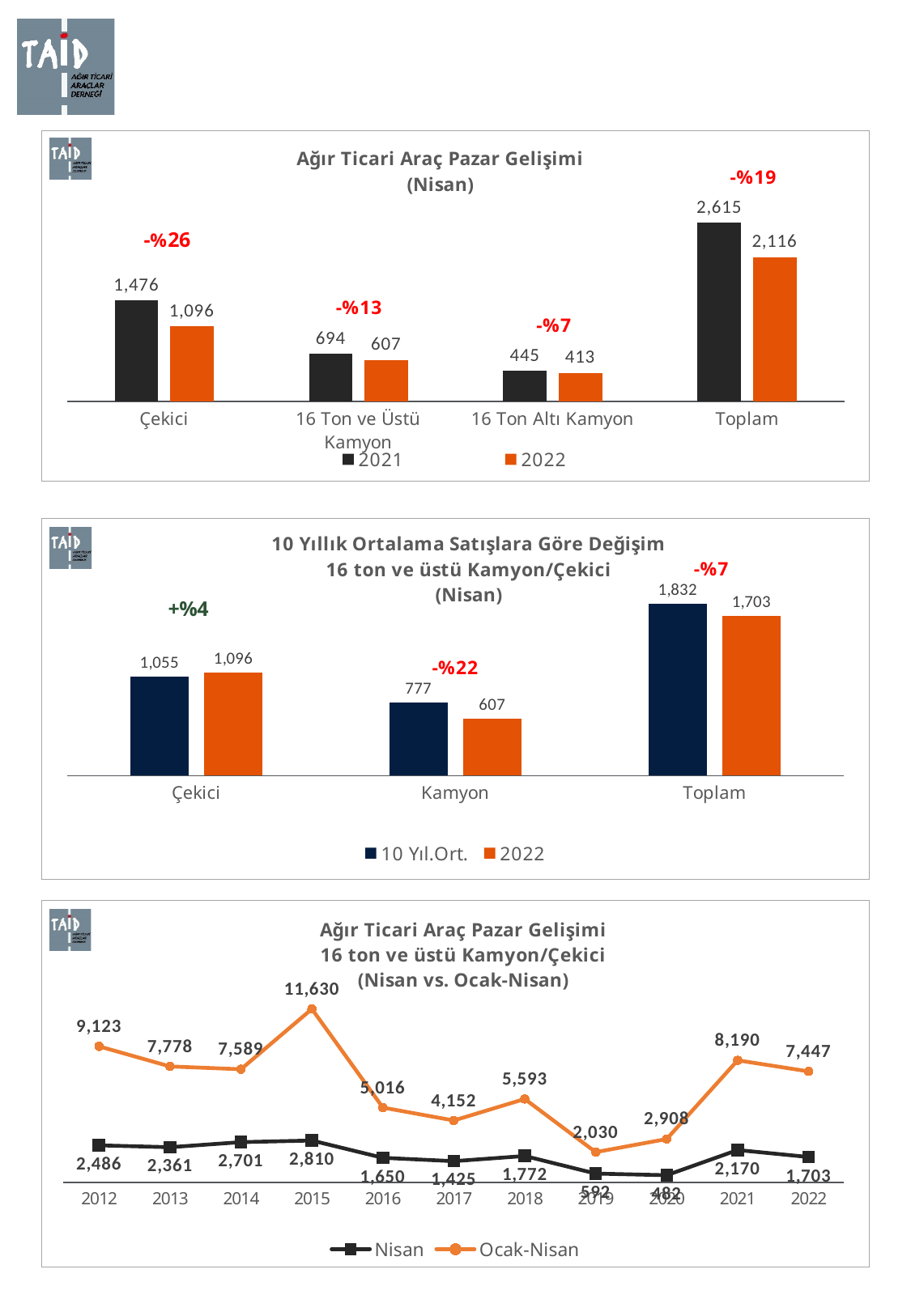
In the top chart 'Ağır Ticari Araç Pazar Gelişimi (Nisan)', what is the 2022 value for Çekici? 1,096 In the bottom chart 'Ağır Ticari Araç Pazar Gelişimi 16 ton ve üstü Kamyon/Çekici (Nisan vs. Ocak-Nisan)', how many years are shown on the x axis? 11 In the top chart 'Ağır Ticari Araç Pazar Gelişimi (Nisan)', which category has the lowest 2022 value? 16 Ton Altı Kamyon What kind of chart is the bottom chart 'Ağır Ticari Araç Pazar Gelişimi 16 ton ve üstü Kamyon/Çekici (Nisan vs. Ocak-Nisan)'? line chart In the middle chart '10 Yıllık Ortalama Satışlara Göre Değişim', what is the 10 Yıl.Ort. value for Kamyon? 777 In the middle chart '10 Yıllık Ortalama Satışlara Göre Değişim', which is larger for Çekici: the 10 Yıl.Ort. value or the 2022 value? 2022 In the bottom chart 'Ağır Ticari Araç Pazar Gelişimi 16 ton ve üstü Kamyon/Çekici (Nisan vs. Ocak-Nisan)', which year has the lowest Nisan value? 2020 In the top chart 'Ağır Ticari Araç Pazar Gelişimi (Nisan)', what is the difference between the 2021 and 2022 values for 16 Ton ve Üstü Kamyon? 87 In the bottom chart 'Ağır Ticari Araç Pazar Gelişimi 16 ton ve üstü Kamyon/Çekici (Nisan vs. Ocak-Nisan)', what is the Ocak-Nisan value for 2015? 11,630 In the middle chart '10 Yıllık Ortalama Satışlara Göre Değişim', how many series does the legend list? 2 In the top chart 'Ağır Ticari Araç Pazar Gelişimi (Nisan)', what percentage change is shown above the Toplam bars? -%19 In the top chart 'Ağır Ticari Araç Pazar Gelişimi (Nisan)', what is the 2021 value for Toplam? 2,615